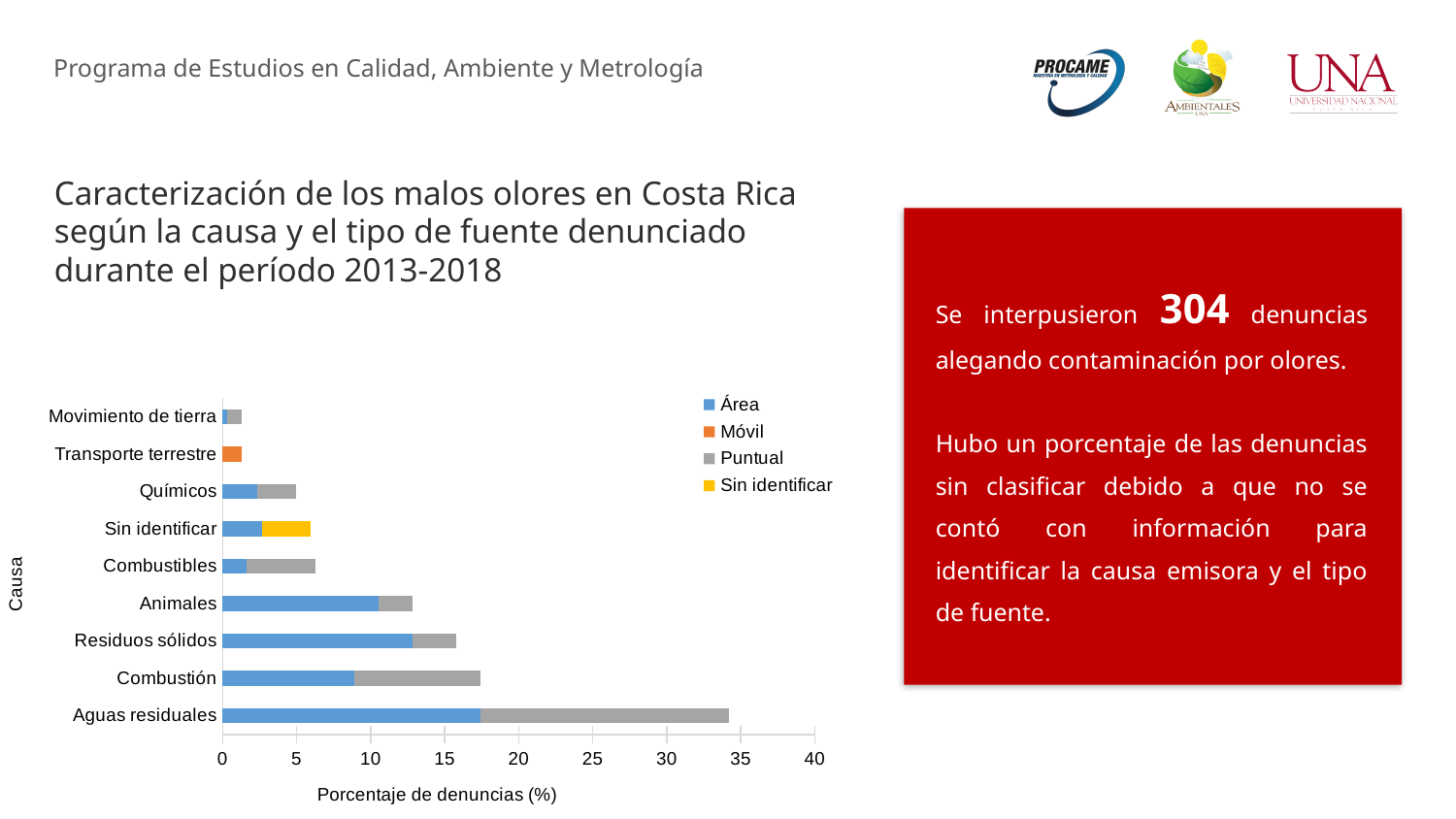
What is the title of the horizontal axis of the chart? Porcentaje de denuncias (%) Is the total value for Combustión greater or less than 15? greater Which has the longer bar, Aguas residuales or Combustión? Aguas residuales Is the total value for Movimiento de tierra greater or less than 5? less Which cause is the only one with a Móvil (orange) segment in its bar? Transporte terrestre Is the total value for Animales greater or less than 15? less How many series does the chart legend list? 4 What kind of chart is shown on the slide? bar chart Which has the longer bar, Animales or Combustibles? Animales Which cause has the longest bar in the chart? Aguas residuales How many causes (categories) are listed on the vertical axis of the chart? 9